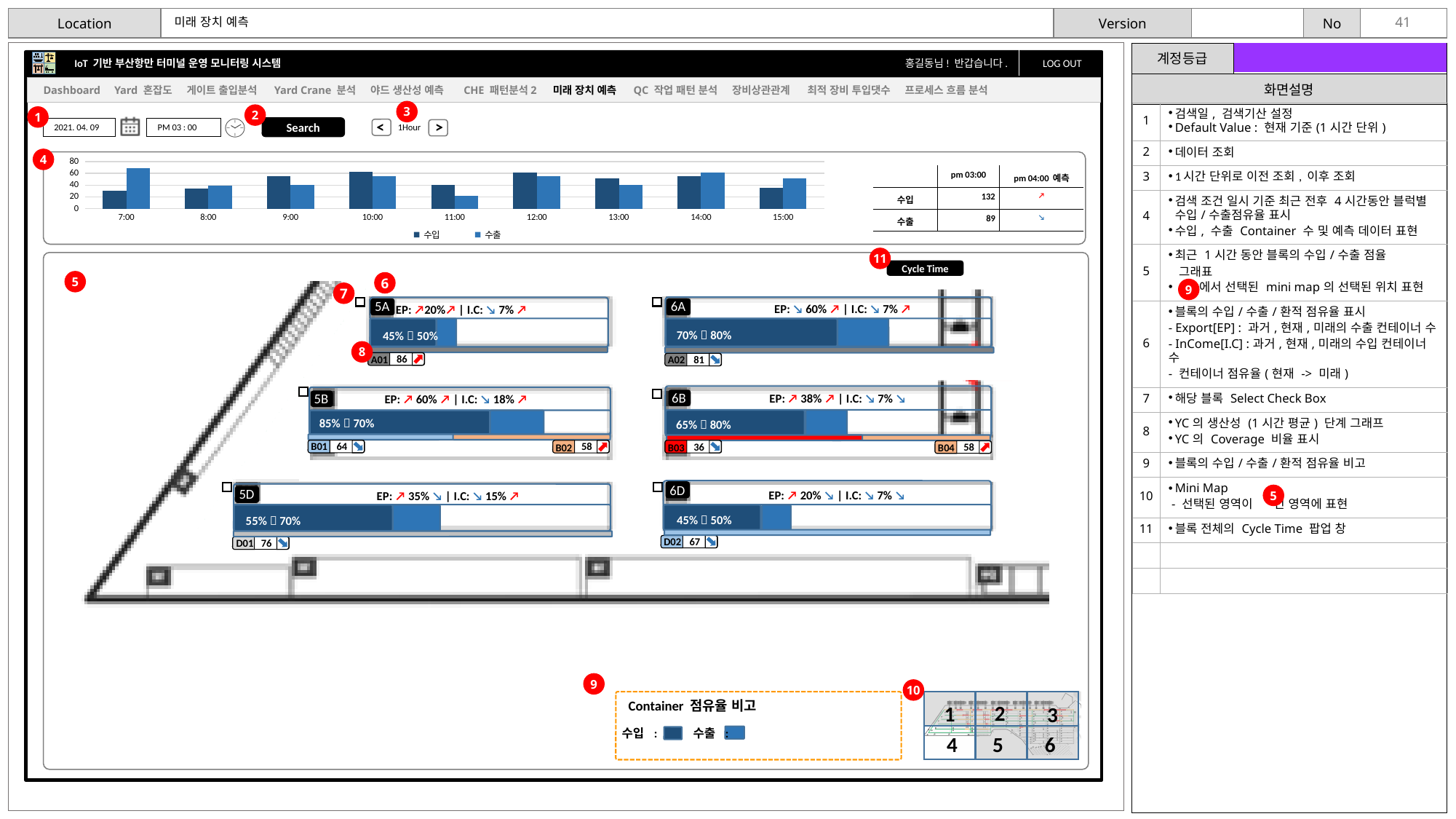
In the top bar chart, is the 수입 value at 7:00 greater or less than 40? less In the top bar chart, at which time is the 수출 value lowest? 11:00 How many series does the legend of the top bar chart list? 2 In the top bar chart, is the 수출 value at 7:00 greater or less than 60? greater What are the two legend entries of the top bar chart? 수입 and 수출 In the top bar chart, at 11:00, which series has the larger value, 수입 or 수출? 수입 What kind of chart is shown in the top-left panel of the dashboard (item 4)? bar chart How many time categories are shown on the x axis of the top bar chart? 9 In the top bar chart, is the 수출 value at 11:00 greater or less than 40? less In the top bar chart, at which time is the 수출 value highest? 7:00 In the top bar chart, at 7:00, which series has the larger value, 수입 or 수출? 수출